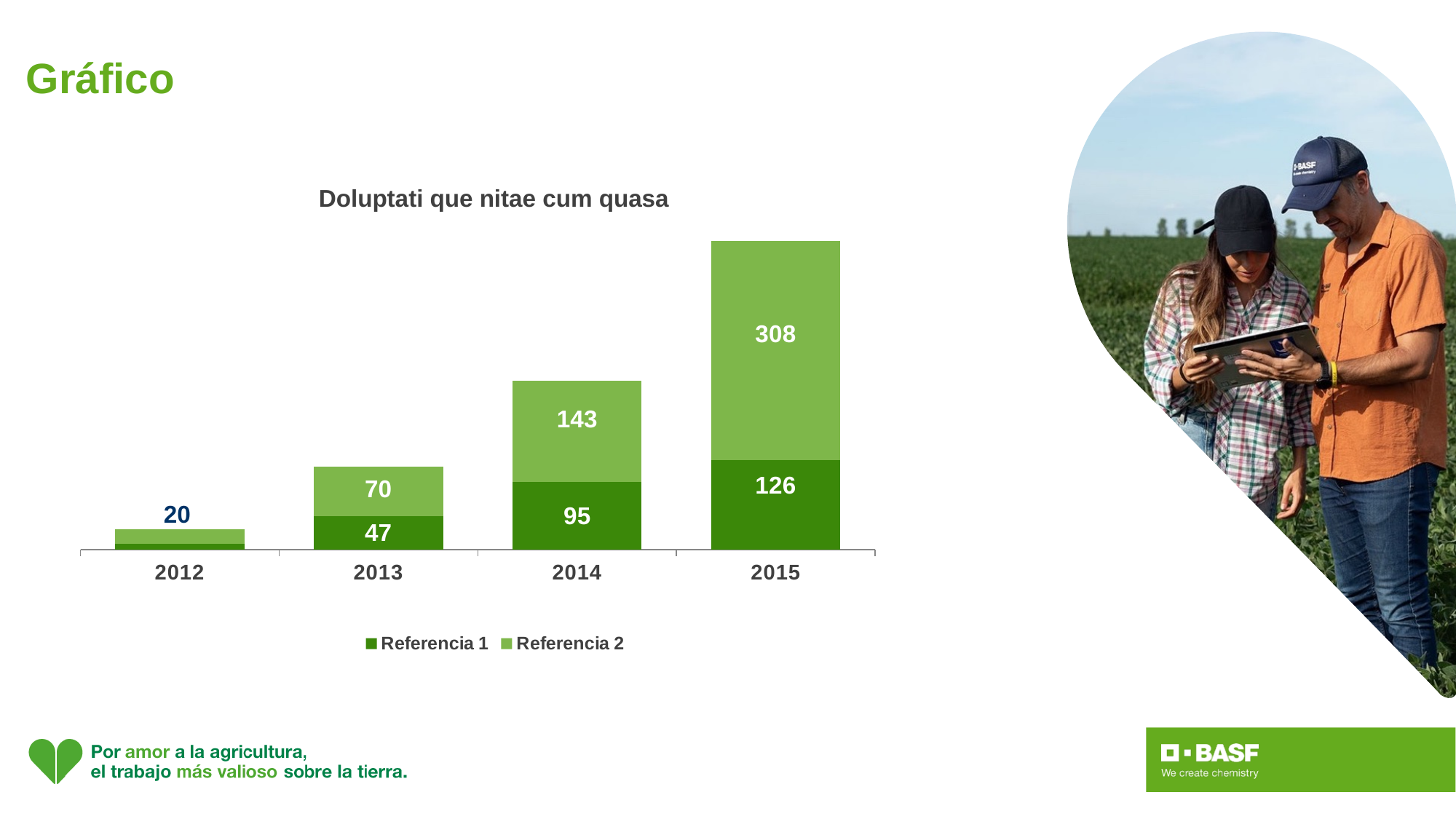
In which year is Referencia 1 highest? 2015 What is the title of the chart? Doluptati que nitae cum quasa Do the Referencia 2 values rise or fall from 2012 to 2015? Rise What is the value of Referencia 2 in 2013? 70 What is the value of Referencia 1 in 2014? 95 What type of chart is shown on the slide? Stacked bar chart How many years are shown on the x axis of the chart? 4 What is the difference between Referencia 2 and Referencia 1 in 2015? 182 What is the total of the stacked bar for 2014? 238 What is the value of Referencia 2 in 2015? 308 How many series does the legend list? 2 In which year is Referencia 2 lowest? 2012